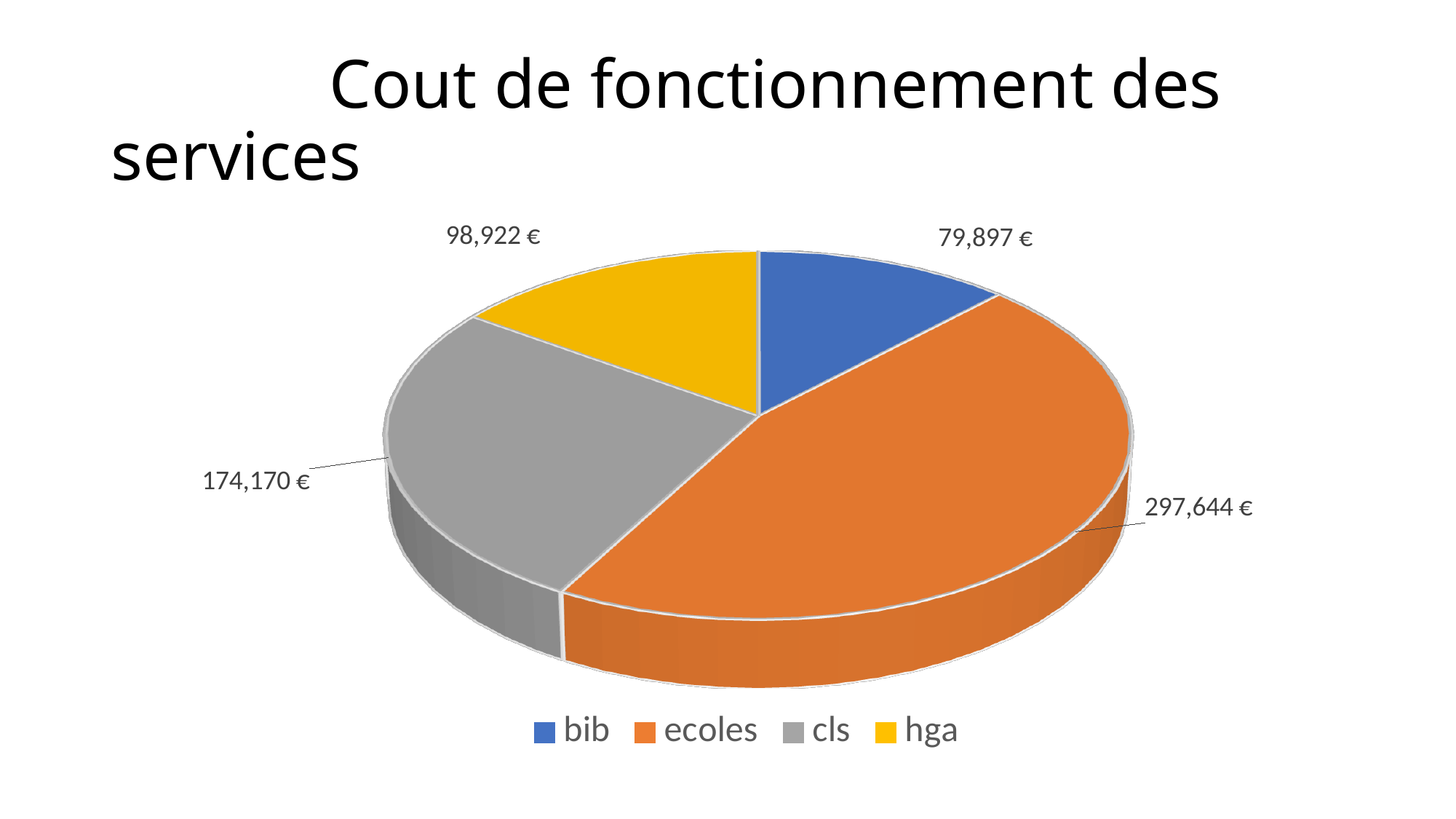
Which is larger, the value for cls or the value for hga? cls Which category has the largest slice? ecoles What type of chart is shown on the slide? pie chart Which category has the smallest slice? bib What is the value for bib? 79,897 € What is the value for cls? 174,170 € What is the title of the chart on the slide? Cout de fonctionnement des services What is the value for hga? 98,922 € What is the value for ecoles? 297,644 € How many categories does the pie chart have? 4 What is the difference between the values for hga and bib? 19,025 € What is the difference between the values for ecoles and cls? 123,474 €